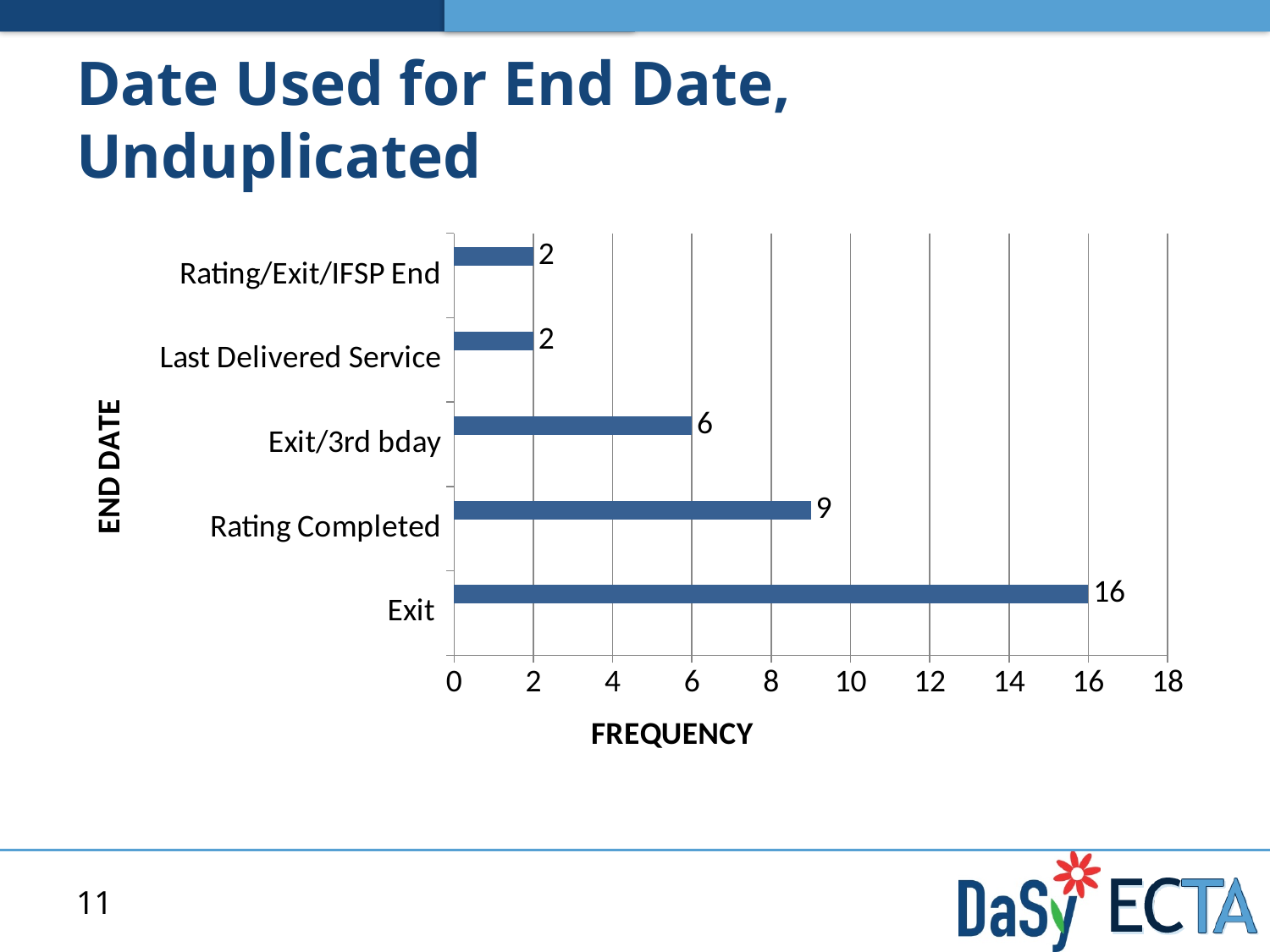
Which has a higher frequency, Rating Completed or Exit/3rd bday? Rating Completed What is the difference in frequency between Exit/3rd bday and Rating/Exit/IFSP End? 4 What is the frequency for Exit/3rd bday? 6 What is the frequency for Last Delivered Service? 2 What is the label of the horizontal axis? FREQUENCY Is the frequency for Exit greater or less than 14? greater What is the difference in frequency between Exit and Rating Completed? 7 How many end date categories are shown in the chart? 5 What is the frequency for Rating Completed? 9 What type of chart is shown on the slide? bar chart Which end date category has the highest frequency? Exit What is the frequency for Exit? 16